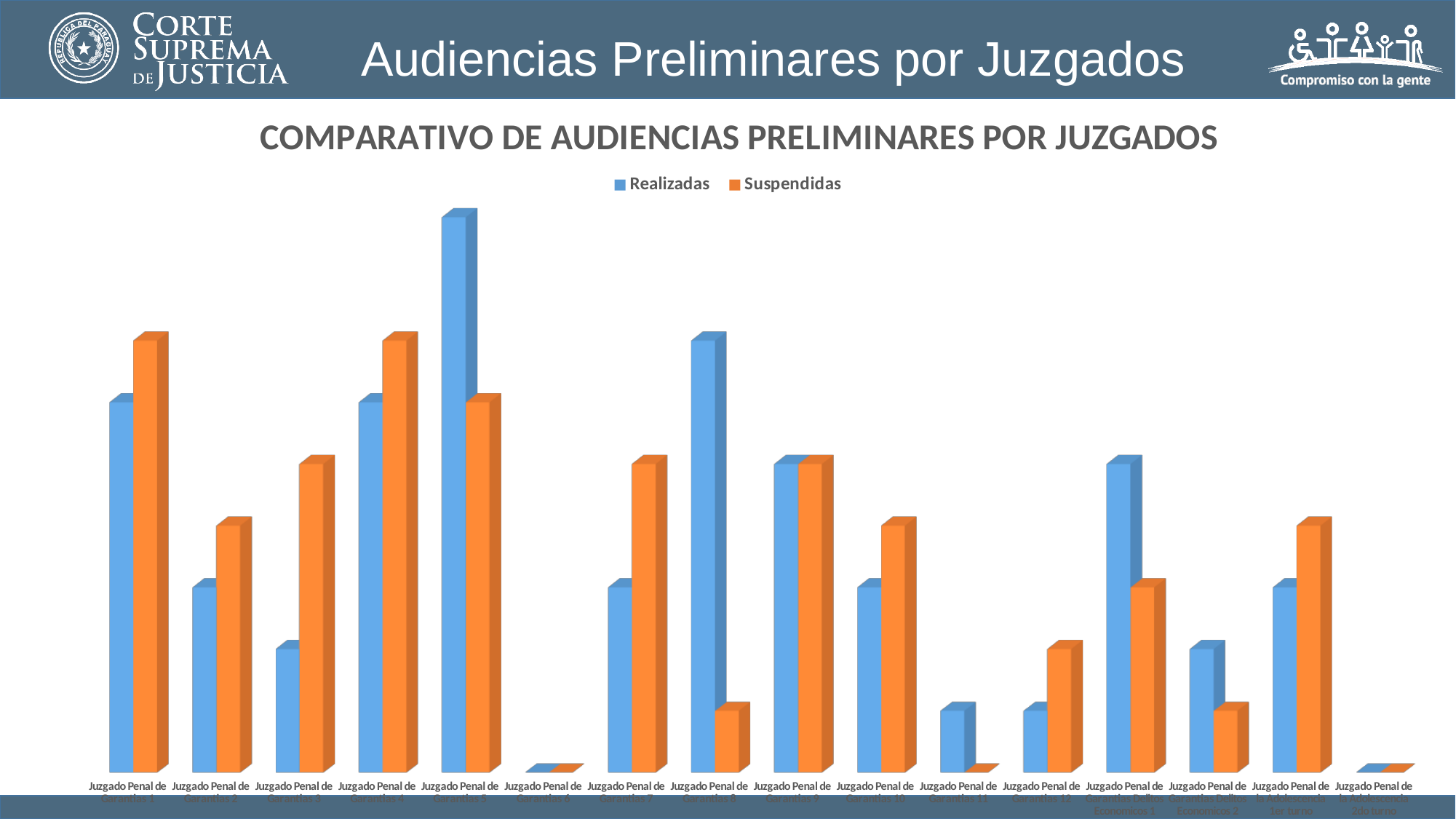
For Juzgado Penal de Garantías Delitos Económicos 1, which is larger: Realizadas or Suspendidas? Realizadas For Juzgado Penal de Garantías 1, which is larger: Realizadas or Suspendidas? Suspendidas For Juzgado Penal de Garantías 3, which is larger: Realizadas or Suspendidas? Suspendidas What kind of chart is shown on the slide? bar chart How many series does the chart legend list? 2 How many juzgados (categories) are shown on the x axis of the chart? 16 Which juzgado has the highest value for Realizadas? Juzgado Penal de Garantías 5 What are the two series named in the chart legend? Realizadas and Suspendidas What is the title of the chart? COMPARATIVO DE AUDIENCIAS PRELIMINARES POR JUZGADOS